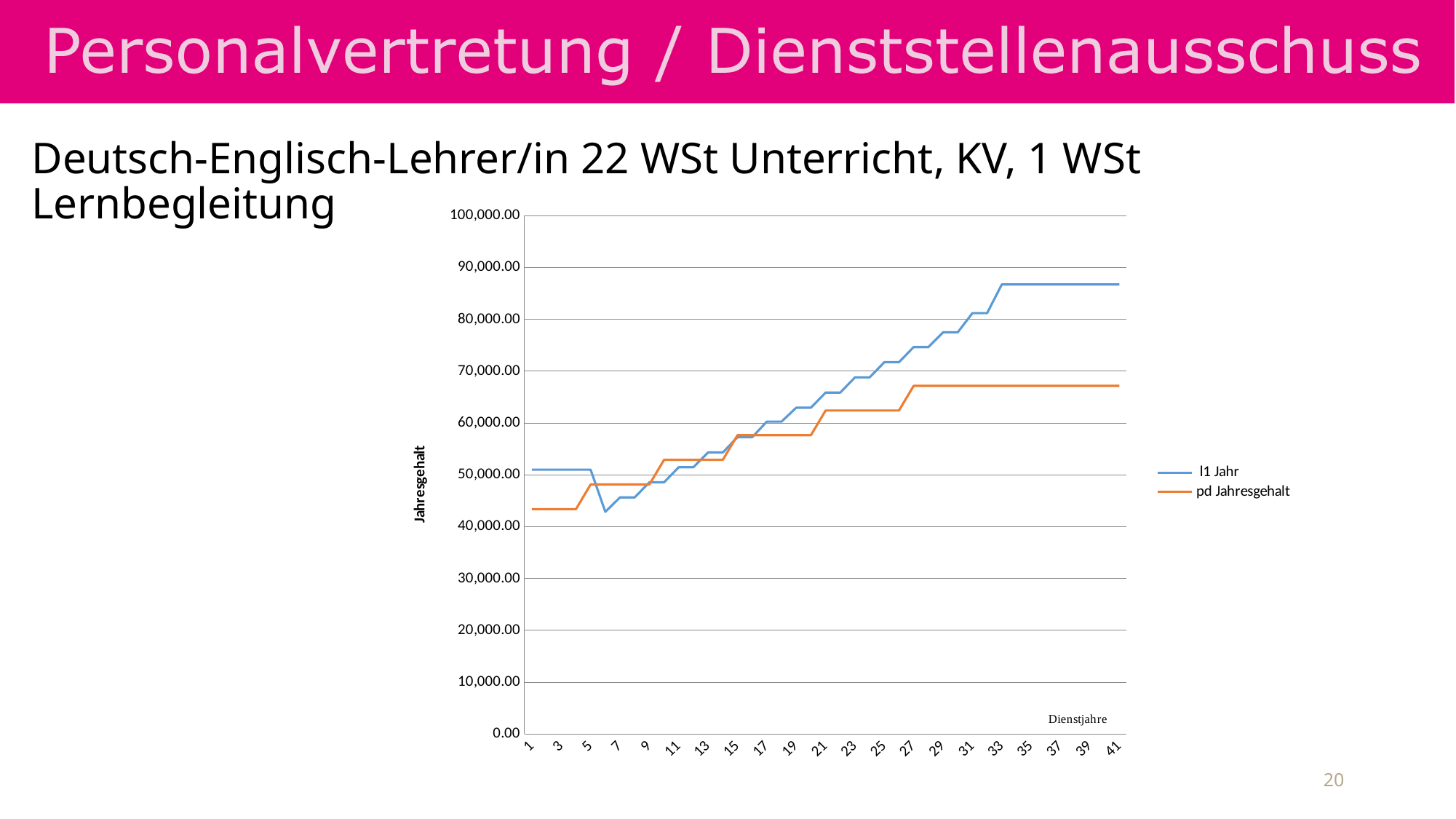
What kind of chart is shown on the slide? line chart What are the two series named in the legend? l1 Jahr and pd Jahresgehalt At Dienstjahr 1, which series has the higher value, l1 Jahr or pd Jahresgehalt? l1 Jahr Overall, does the l1 Jahr series rise or fall from Dienstjahr 1 to Dienstjahr 41? rise Is the value of pd Jahresgehalt at Dienstjahr 41 greater or less than 70,000.00? less Is the value of pd Jahresgehalt at Dienstjahr 25 greater or less than 60,000.00? greater Is the value of l1 Jahr at Dienstjahr 41 greater or less than 80,000.00? greater How many series does the legend list? 2 At Dienstjahr 7, which series has the higher value, l1 Jahr or pd Jahresgehalt? pd Jahresgehalt At Dienstjahr 41, which series has the higher value, l1 Jahr or pd Jahresgehalt? l1 Jahr What is the label of the vertical axis? Jahresgehalt